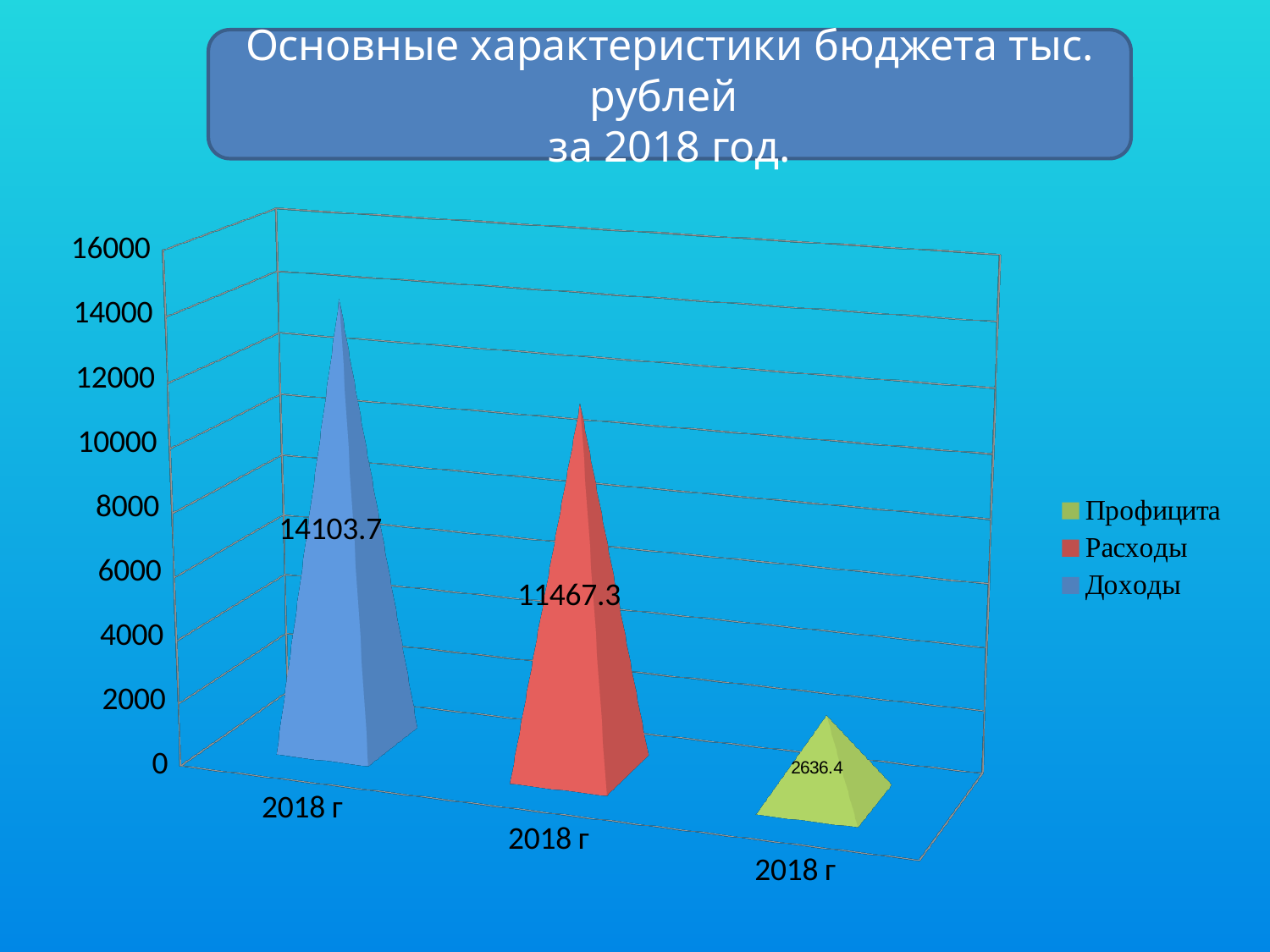
What is the value for Профицита? 2636.4 Is the value for Расходы greater or less than 10000? greater What kind of chart is shown? bar chart How many series does the legend list? 3 Which series has the lowest value? Профицита What colour represents Профицита in the legend? green What is the difference between Расходы and Профицита? 8830.9 What is the value for Расходы? 11467.3 Which is larger, Расходы or Профицита? Расходы What is the value for Доходы? 14103.7 What is the difference between Доходы and Расходы? 2636.4 Which series has the highest value? Доходы